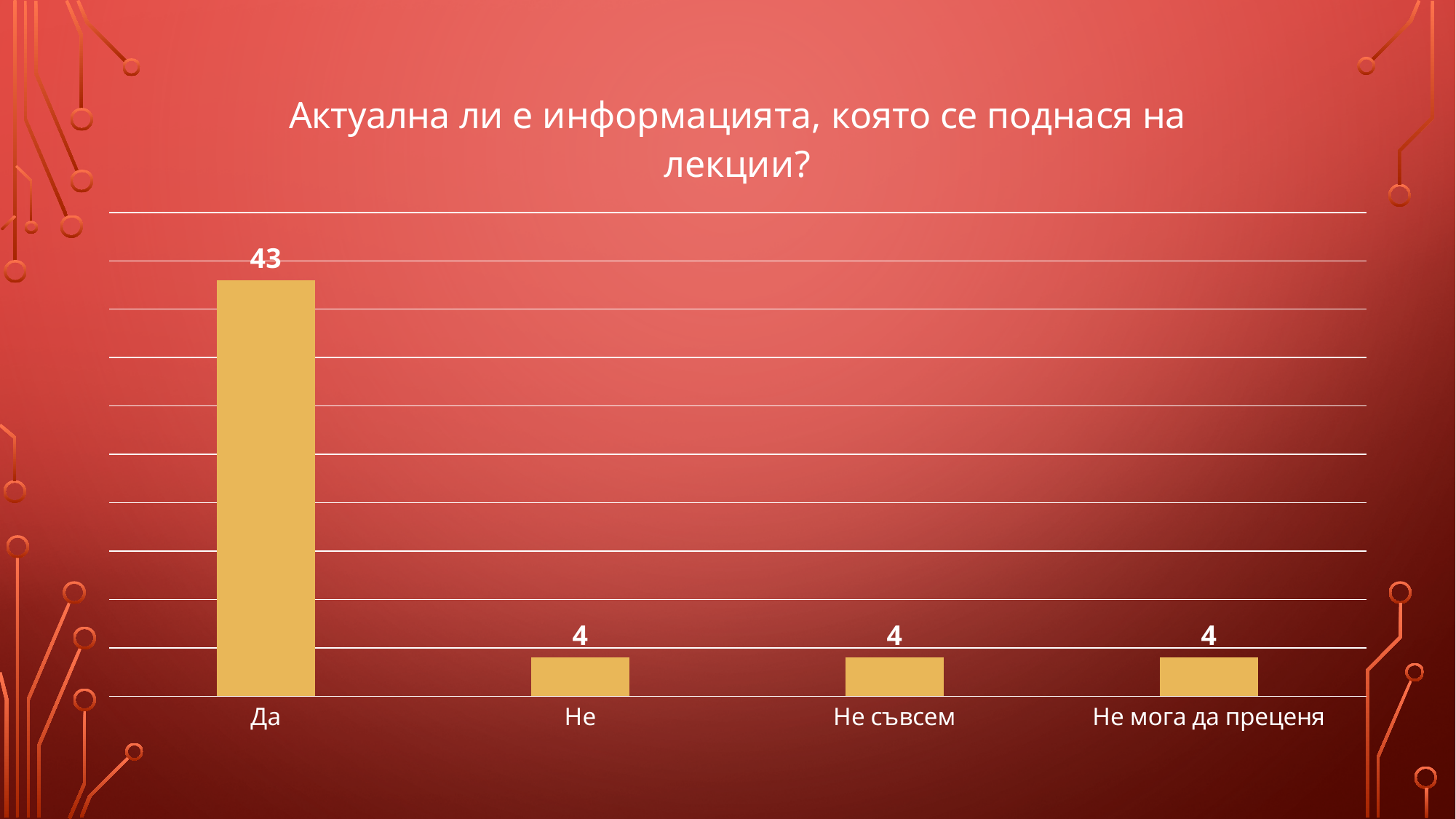
What is the difference between the values for "Да" and "Не"? 39 What kind of chart is shown on the slide? Bar chart What is the value for "Не"? 4 How many categories share the value 4? 3 How many categories are shown on the x axis? 4 Which is larger, the value for "Да" or the value for "Не съвсем"? Да What is the value for "Да"? 43 What is the value for "Не мога да преценя"? 4 What is the value for "Не съвсем"? 4 What is the title of the chart? Актуална ли е информацията, която се поднася на лекции? What is the total of all four values shown in the chart? 55 Which category has the highest value? Да